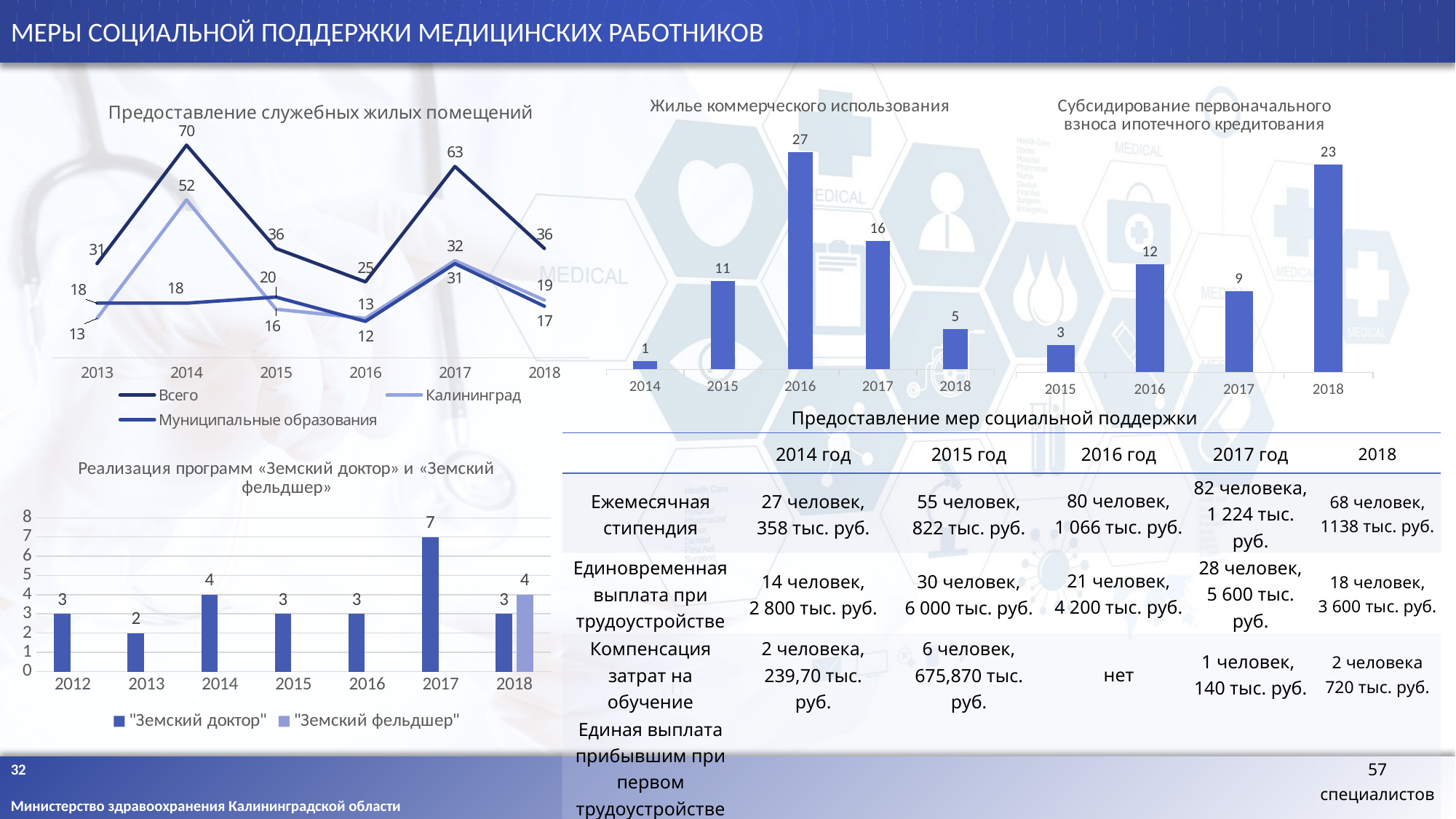
In the line chart 'Предоставление служебных жилых помещений', what is the value of the 'Калининград' series in 2017? 32 In the line chart 'Предоставление служебных жилых помещений', what is the value of the 'Всего' series in 2014? 70 In the chart 'Субсидирование первоначального взноса ипотечного кредитования', what is the difference between the values for 2018 and 2017? 14 In the chart 'Субсидирование первоначального взноса ипотечного кредитования', how many years are shown on the x axis? 4 In the chart 'Реализация программ «Земский доктор» и «Земский фельдшер»', what is the value for 'Земский доктор' in 2017? 7 In the line chart 'Предоставление служебных жилых помещений', how many series does the legend list? 3 In the line chart 'Предоставление служебных жилых помещений', is the 'Всего' value in 2015 larger or smaller than in 2016? larger What type of chart is 'Жилье коммерческого использования'? bar chart In the chart 'Реализация программ «Земский доктор» и «Земский фельдшер»', what is the value for 'Земский фельдшер' in 2018? 4 In the chart 'Жилье коммерческого использования', which year has the lowest value? 2014 In the chart 'Жилье коммерческого использования', what is the value for 2016? 27 In the chart 'Субсидирование первоначального взноса ипотечного кредитования', which year has the highest value? 2018